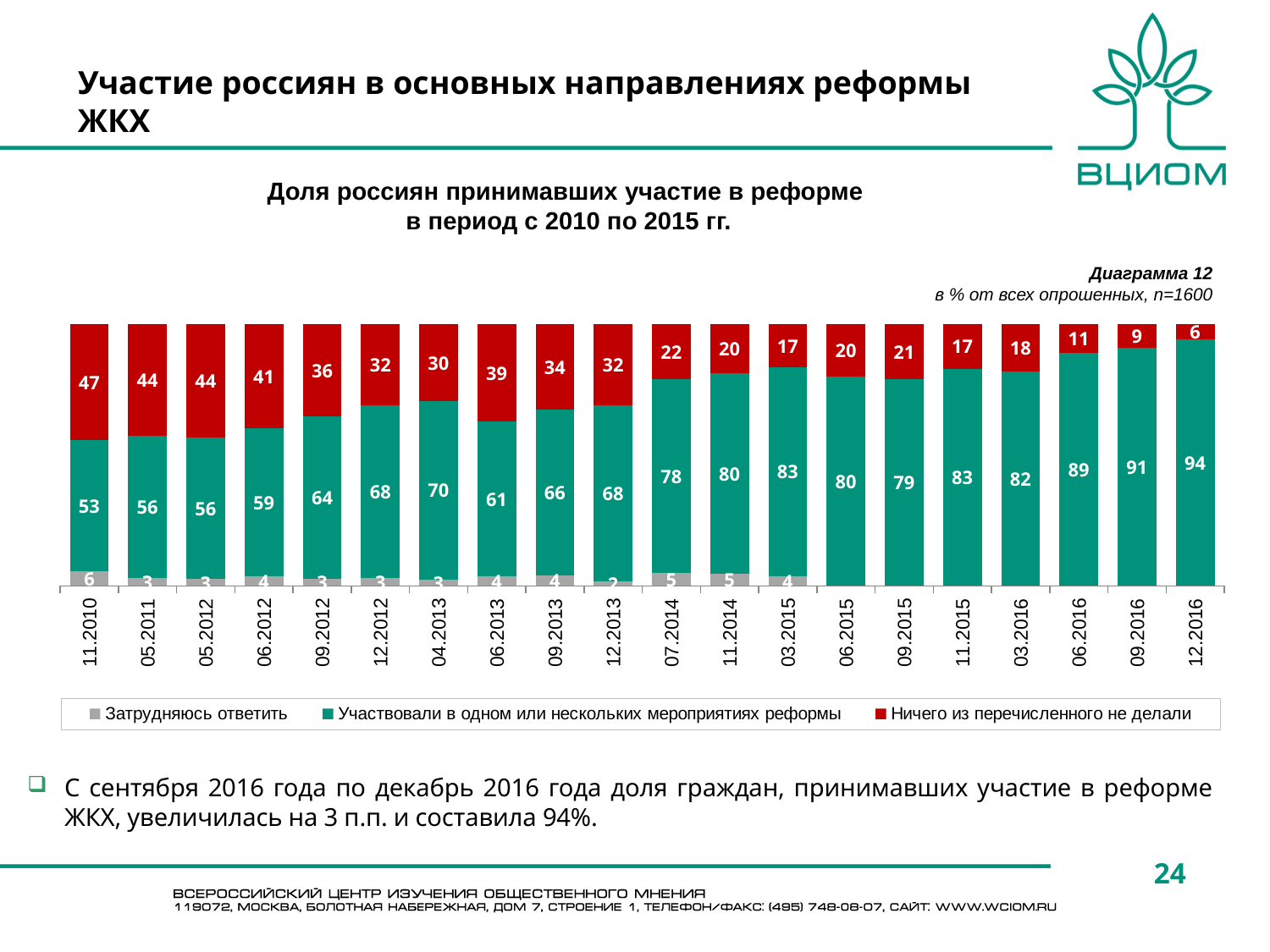
What colour represents "Ничего из перечисленного не делали" in the chart? Red What is the value for "Затрудняюсь ответить" in 11.2010? 6 How many series does the legend list? 3 How many periods are shown on the x axis of the chart? 20 In which period is the value for "Участвовали в одном или нескольких мероприятиях реформы" the highest? 12.2016 Does the value for "Участвовали в одном или нескольких мероприятиях реформы" generally rise or fall from 11.2010 to 12.2016? Rise What is the value for "Участвовали в одном или нескольких мероприятиях реформы" in 12.2016? 94 In which period is the value for "Ничего из перечисленного не делали" the lowest? 12.2016 By how much did the value for "Участвовали в одном или нескольких мероприятиях реформы" change from 09.2016 to 12.2016? 3 Which period has the larger value for "Участвовали в одном или нескольких мероприятиях реформы": 04.2013 or 06.2013? 04.2013 What kind of chart is shown on the slide? Stacked bar chart What is the value for "Ничего из перечисленного не делали" in 11.2010? 47